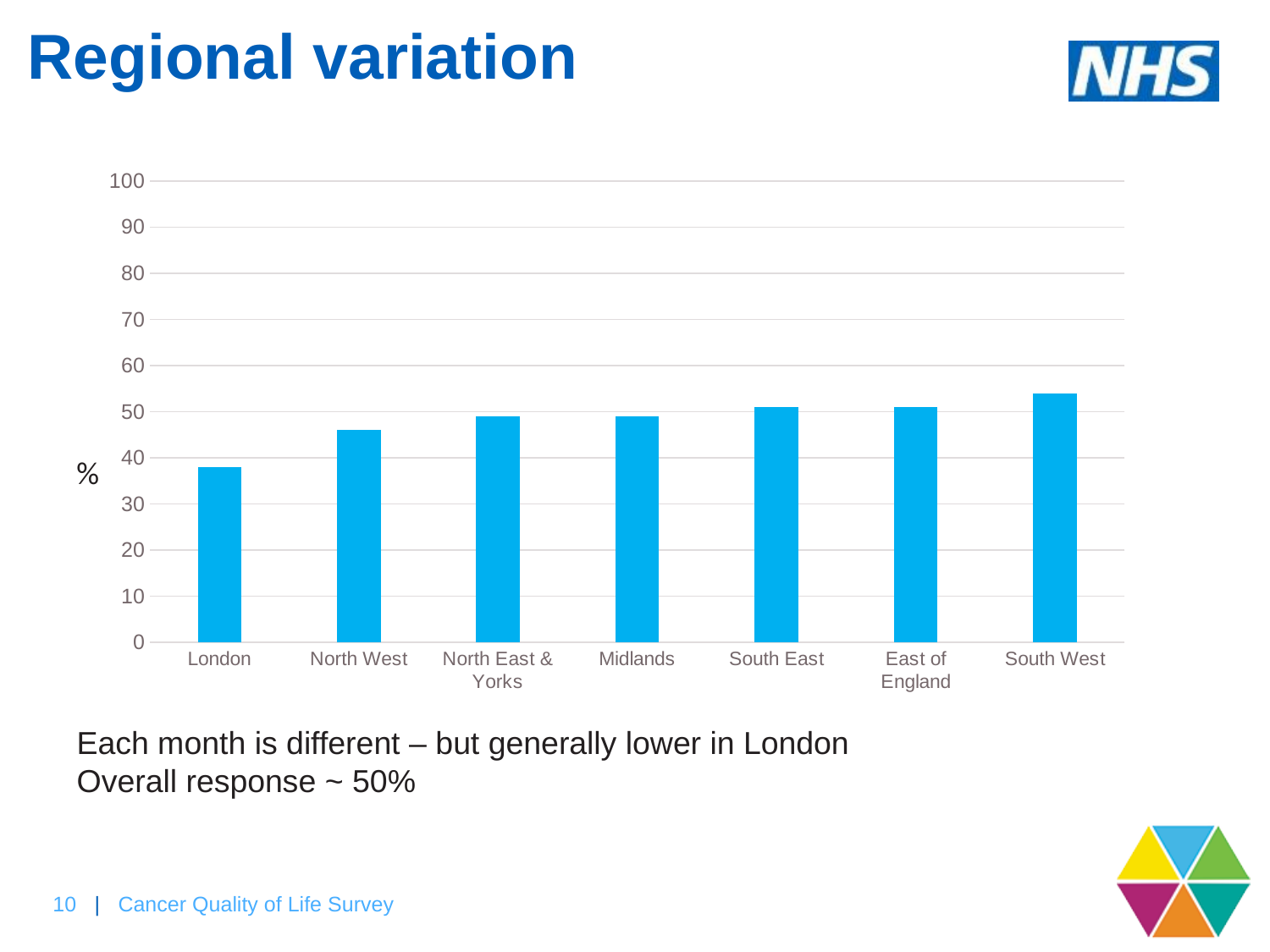
Do the values generally rise or fall moving from London on the left to South West on the right? rise Is the value for North West greater or less than 50? less Which region has the highest value in the chart? South West What kind of chart is shown on the slide? bar chart Which is larger, the value for North West or the value for Midlands? Midlands Which region has the lowest value in the chart? London How many regions are shown on the x axis of the chart? 7 Which is larger, the value for London or the value for North West? North West Is the value for London greater or less than 40? less What label is shown on the y axis of the chart? % Is the value for London greater or less than 30? greater